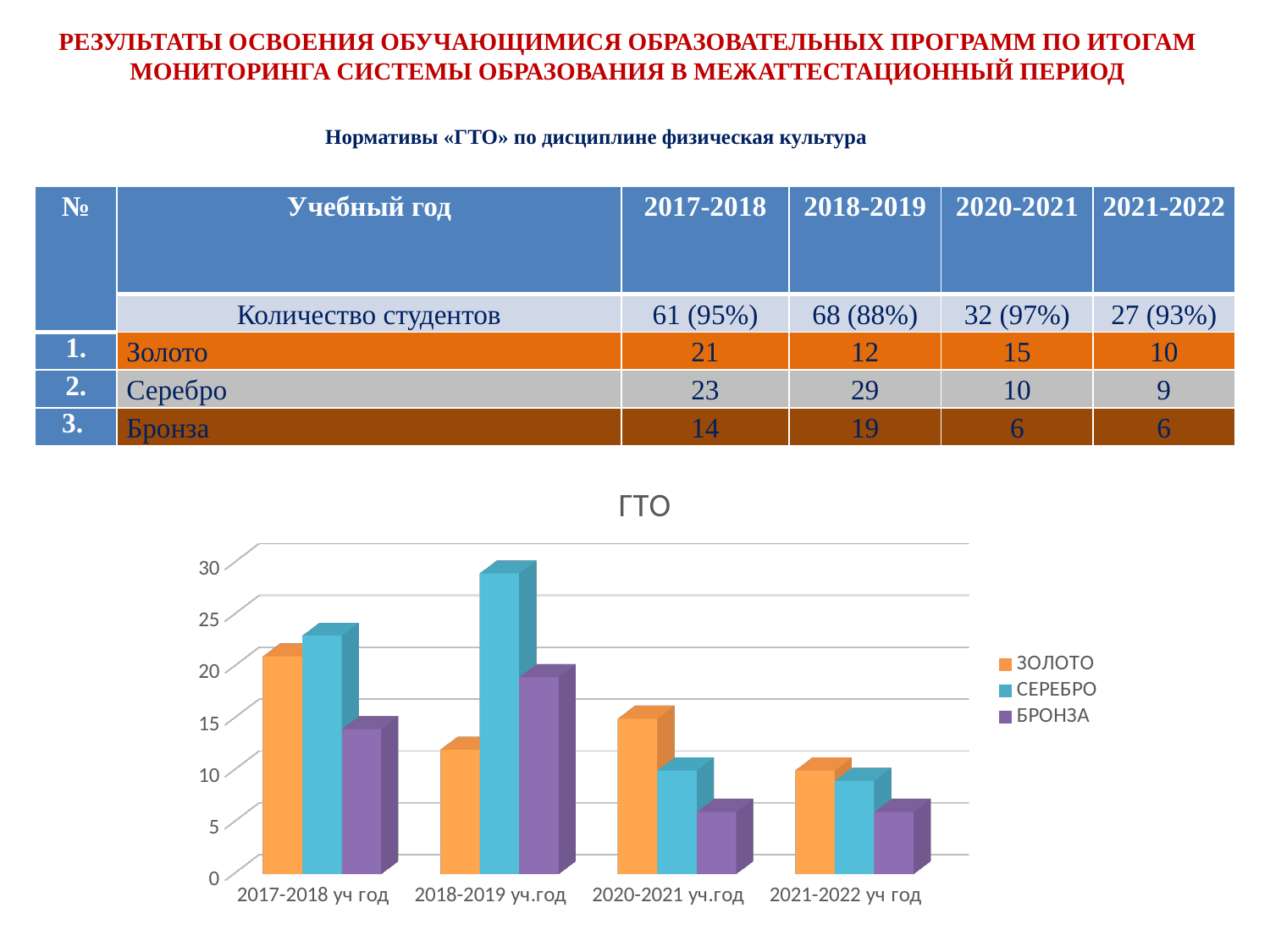
In the ГТО chart, is the СЕРЕБРО value for 2018-2019 уч.год greater or less than 25? greater How many academic-year categories are shown on the x axis of the ГТО chart? 4 According to the table, what is the Серебро value for 2018-2019? 29 Which series is highest in the 2018-2019 уч.год category of the ГТО chart? СЕРЕБРО Does the БРОНЗА series in the ГТО chart rise or fall from 2018-2019 уч.год to 2021-2022 уч год? fall What colour represents the СЕРЕБРО series in the ГТО chart? blue Which series is lowest in the 2017-2018 уч год category of the ГТО chart? БРОНЗА In the ГТО chart, is the БРОНЗА value for 2020-2021 уч.год greater or less than 10? less In the ГТО chart, which is larger for 2020-2021 уч.год: ЗОЛОТО or СЕРЕБРО? ЗОЛОТО How many series does the legend of the ГТО chart list? 3 What kind of chart is the ГТО chart? bar chart According to the table, what is the Золото value for 2017-2018? 21